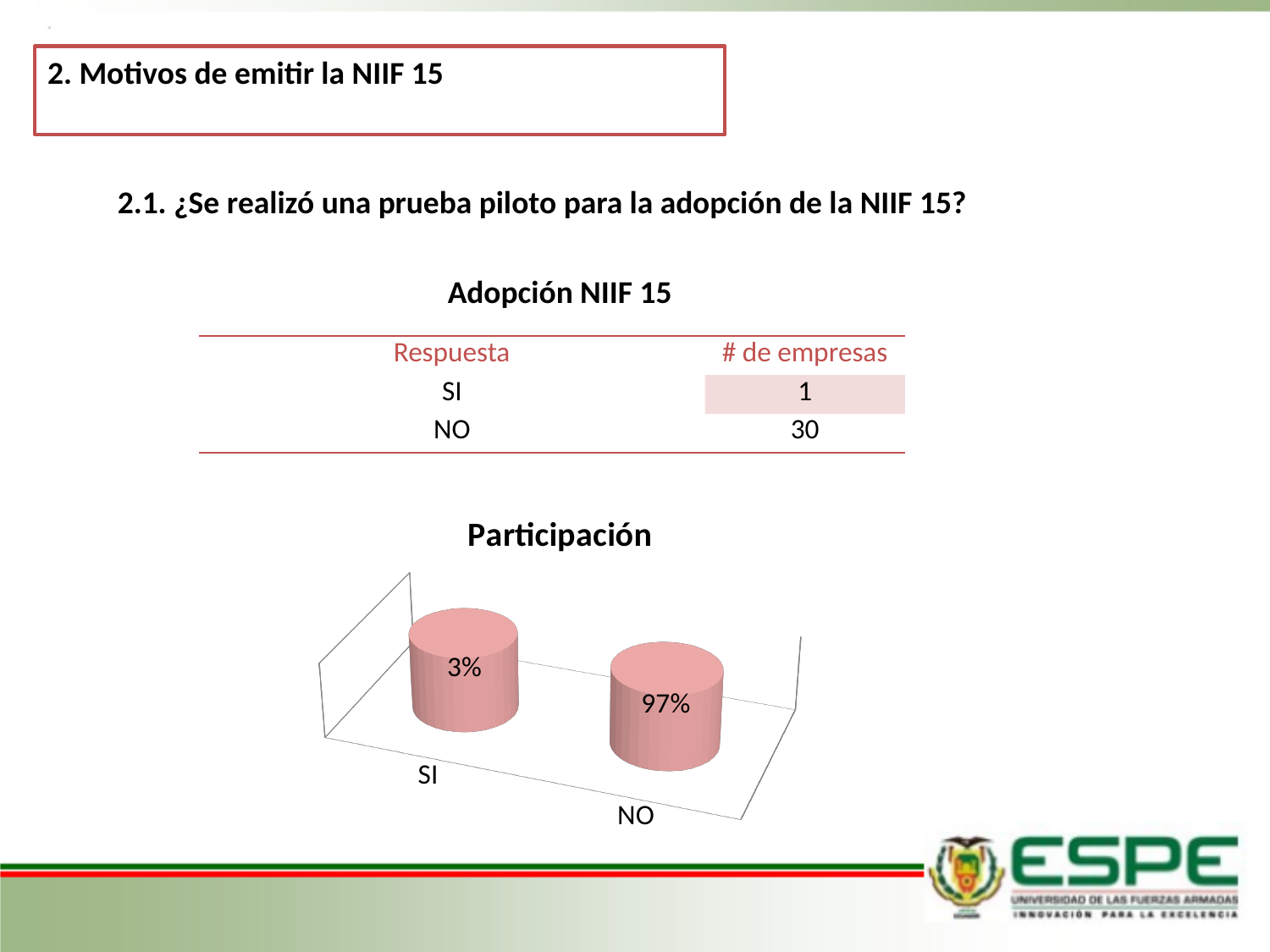
What colour are the bars in the "Participación" chart? Pink In the "Participación" chart, what is the difference between the values for NO and SI? 94% How many categories are shown in the "Participación" chart? 2 What kind of chart is the "Participación" chart? Bar chart In the "Participación" chart, which category has the lowest value? SI In the "Participación" chart, what is the value shown for NO? 97% In the "Participación" chart, which is larger, the value for SI or the value for NO? NO What is the title of the chart on the slide? Participación In the "Participación" chart, which category has the highest value? NO In the "Participación" chart, what is the value shown for SI? 3%